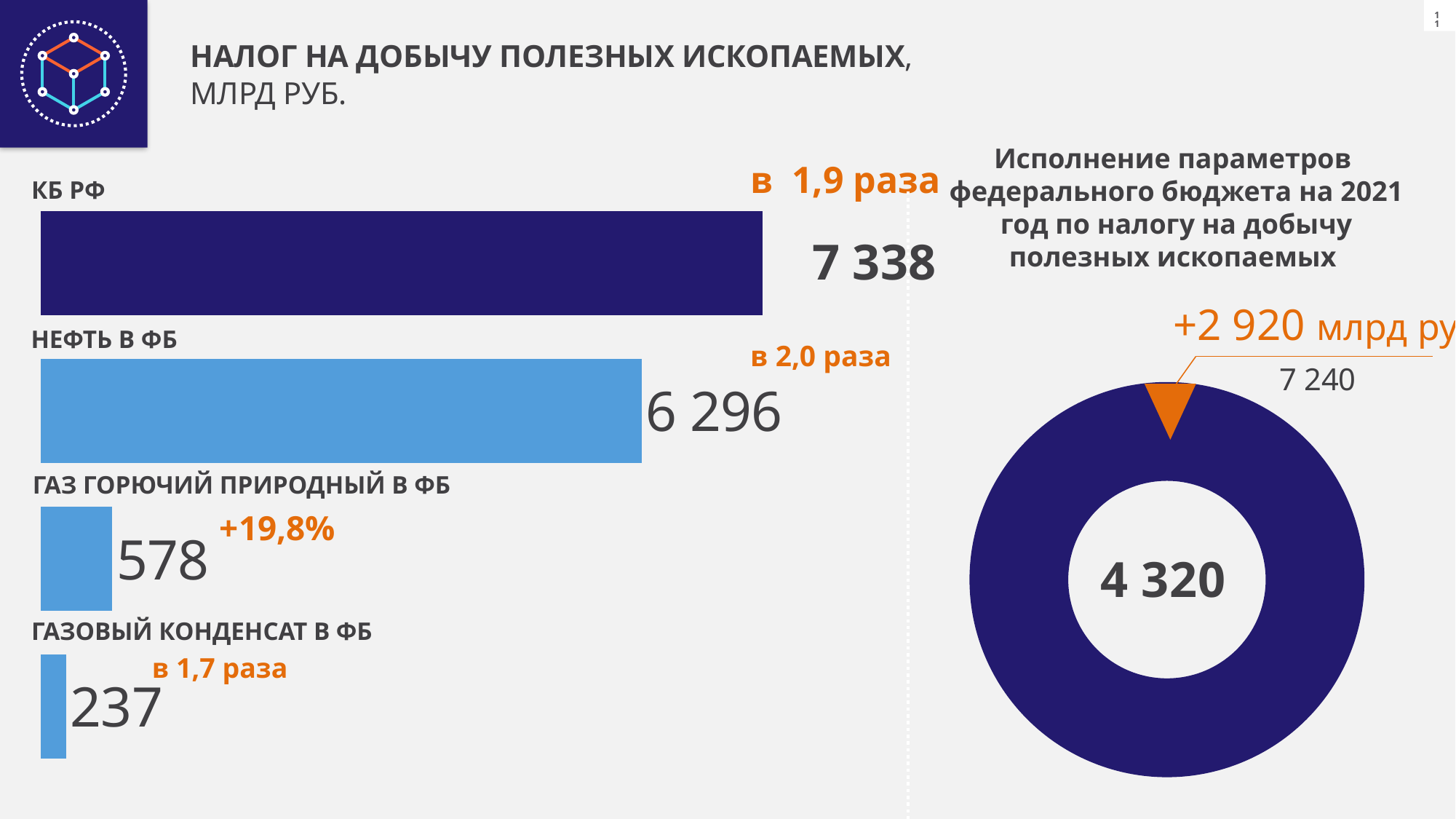
On the bar chart on the left, what is the value for ГАЗОВЫЙ КОНДЕНСАТ В ФБ? 237 On the bar chart on the left, which category has the lowest value? ГАЗОВЫЙ КОНДЕНСАТ В ФБ On the bar chart on the left, what is the value for ГАЗ ГОРЮЧИЙ ПРИРОДНЫЙ В ФБ? 578 On the bar chart on the left, what is the value for КБ РФ? 7 338 What value is printed in the centre of the donut chart on the right? 4 320 On the bar chart on the left, which is larger: ГАЗ ГОРЮЧИЙ ПРИРОДНЫЙ В ФБ or ГАЗОВЫЙ КОНДЕНСАТ В ФБ? ГАЗ ГОРЮЧИЙ ПРИРОДНЫЙ В ФБ On the bar chart on the left, what is the difference between the values for ГАЗ ГОРЮЧИЙ ПРИРОДНЫЙ В ФБ and ГАЗОВЫЙ КОНДЕНСАТ В ФБ? 341 On the bar chart on the left, what is the difference between the values for КБ РФ and НЕФТЬ В ФБ? 1 042 On the bar chart on the left, which category has the highest value? КБ РФ What kind of chart is shown on the left of the slide? Bar chart How many categories does the bar chart on the left show? 4 On the bar chart on the left, what is the value for НЕФТЬ В ФБ? 6 296